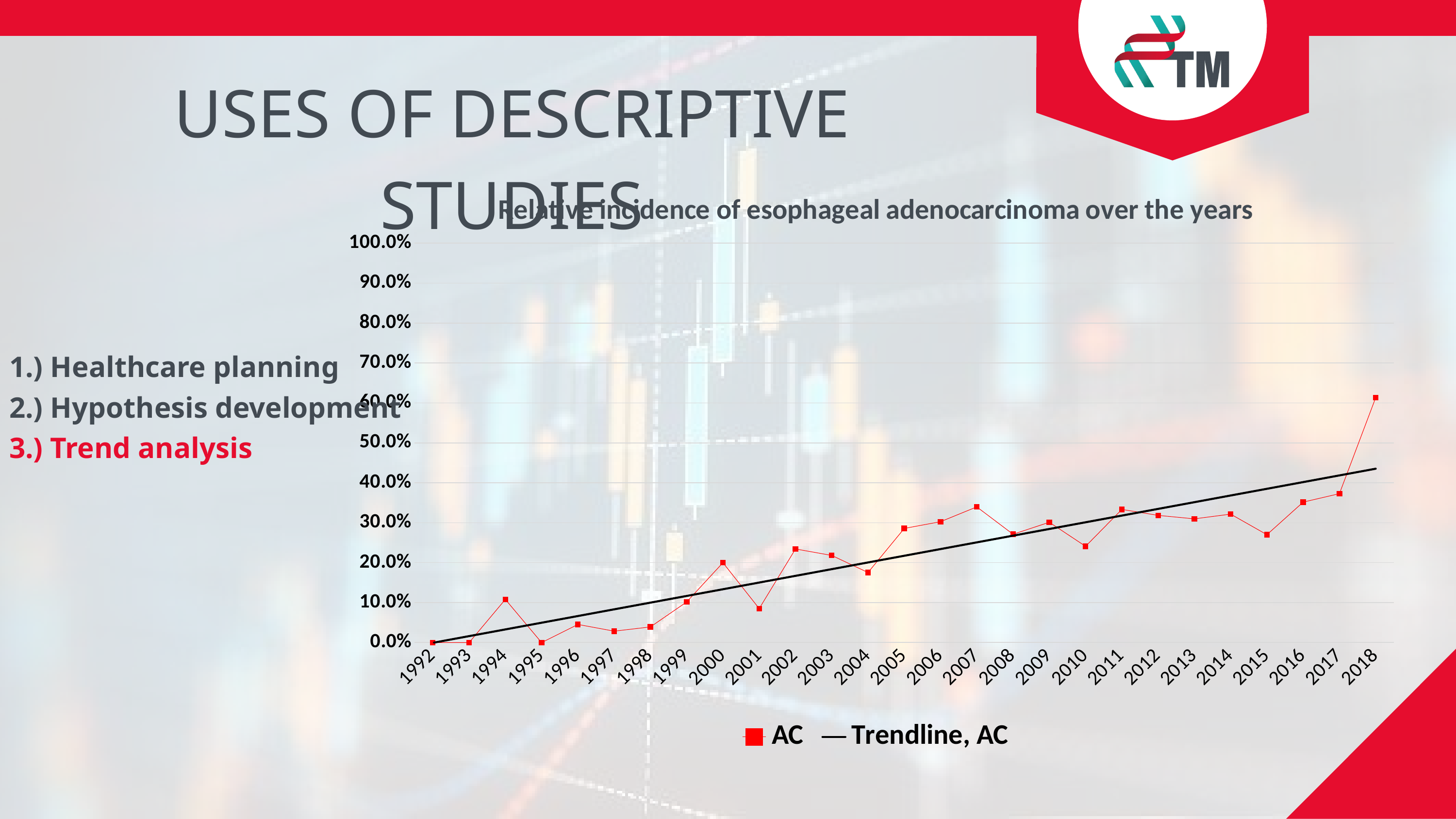
Which year has the larger AC value, 2007 or 2010? 2007 Is the AC value for 2010 greater or less than 30.0%? less How many series does the chart legend list? 2 Is the AC value for 2001 greater or less than 20.0%? less Overall, does the AC series rise or fall from 1992 to 2018? rise Which year has the highest AC value in the chart? 2018 Which year has the larger AC value, 2000 or 2001? 2000 Is the AC value for 2018 greater or less than 50.0%? greater What is the title of the chart? Relative incidence of esophageal adenocarcinoma over the years How many years are plotted along the x axis of the chart? 27 What type of chart is shown on the slide? line chart What is the AC value for 1992? 0.0%